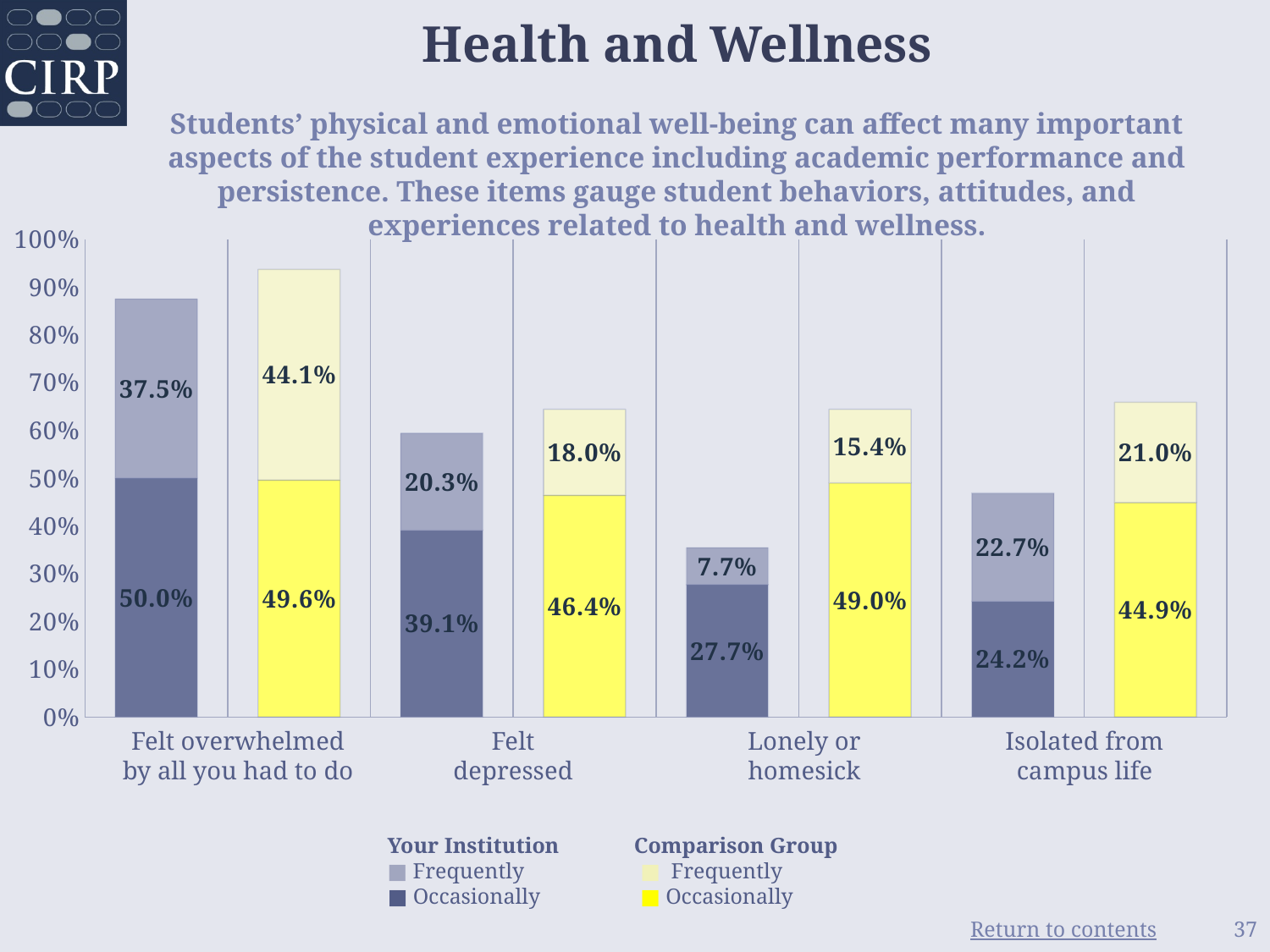
What is the total height of the Your Institution stacked bar for Felt overwhelmed by all you had to do? 87.5% What is the difference between the Comparison Group and Your Institution 'Frequently' values for Lonely or homesick? 7.7% What kind of chart is shown on the slide? Stacked bar chart Among the Your Institution 'Frequently' values, which category has the lowest percentage? Lonely or homesick What is the total height of the Comparison Group stacked bar for Isolated from campus life? 65.9% How many series does the legend list? 4 What percentage of students at Your Institution reported frequently feeling overwhelmed by all they had to do? 37.5% Which is larger for Felt depressed: the Your Institution 'Frequently' value or the Comparison Group 'Frequently' value? Your Institution 'Frequently' (20.3%) How many categories are shown on the x axis of the chart? 4 What percentage of the Comparison Group reported occasionally feeling lonely or homesick? 49.0% What percentage of students at Your Institution reported occasionally feeling isolated from campus life? 24.2% Among the Comparison Group 'Occasionally' values, which category has the highest percentage? Felt overwhelmed by all you had to do